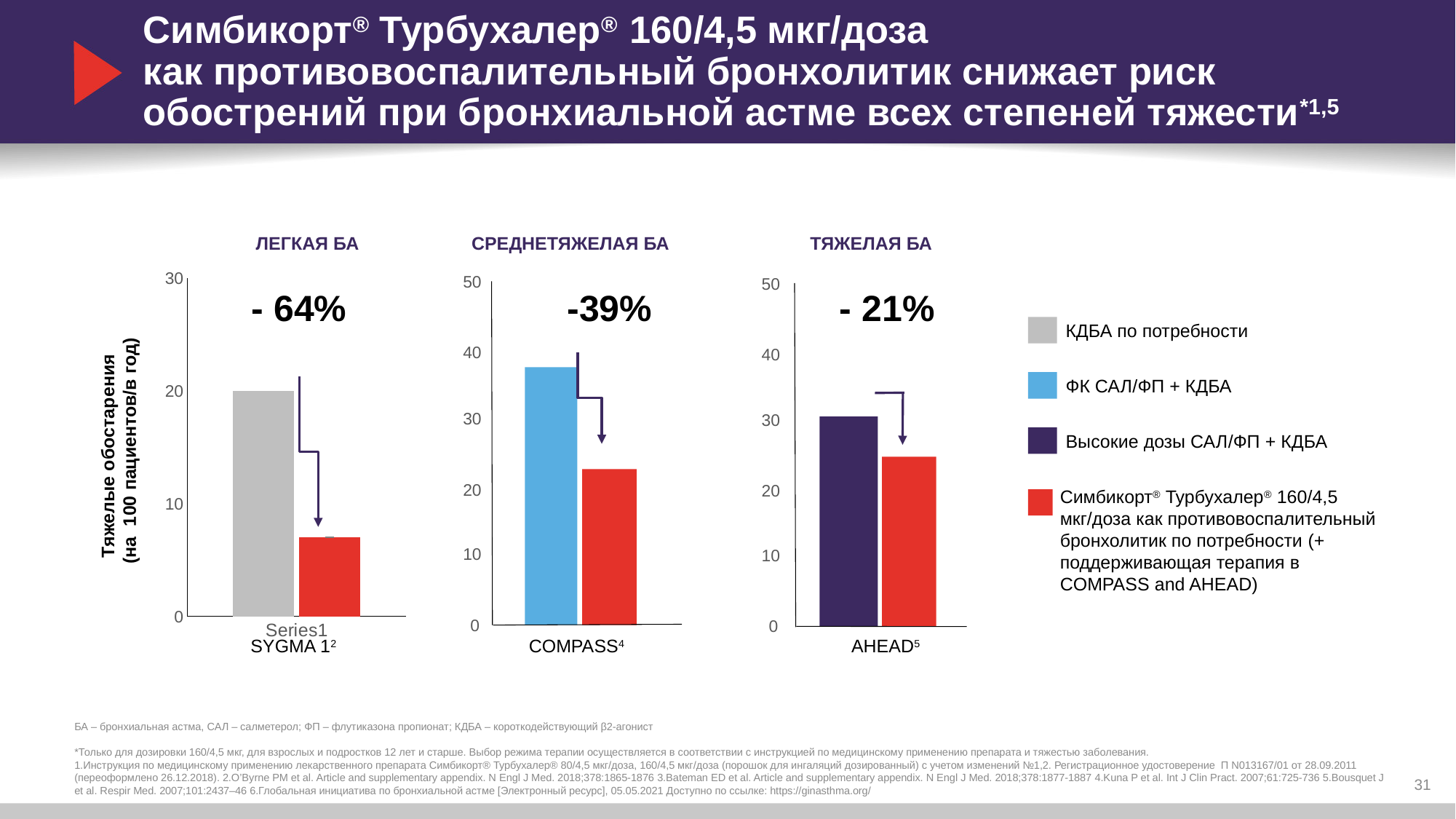
In the ЛЕГКАЯ БА (SYGMA 1) chart, which bar is taller: the gray КДБА по потребности bar or the red Симбикорт bar? the gray КДБА по потребности bar What percentage reduction is annotated on the ЛЕГКАЯ БА (SYGMA 1) chart? - 64% In the ЛЕГКАЯ БА (SYGMA 1) chart, is the value for the red Симбикорт bar greater or less than 10? less In the СРЕДНЕТЯЖЕЛАЯ БА (COMPASS) chart, which bar is lower: the blue ФК САЛ/ФП + КДБА bar or the red Симбикорт bar? the red Симбикорт bar What is the maximum value shown on the y axis of the СРЕДНЕТЯЖЕЛАЯ БА (COMPASS) chart? 50 What percentage reduction is annotated on the ТЯЖЕЛАЯ БА (AHEAD) chart? - 21% In the СРЕДНЕТЯЖЕЛАЯ БА (COMPASS) chart, is the value for the blue ФК САЛ/ФП + КДБА bar greater or less than 30? greater In the СРЕДНЕТЯЖЕЛАЯ БА (COMPASS) chart, is the value for the red Симбикорт bar greater or less than 30? less How many bars are shown in the СРЕДНЕТЯЖЕЛАЯ БА (COMPASS) chart? 2 What kind of chart is used for the ЛЕГКАЯ БА (SYGMA 1) panel? bar chart